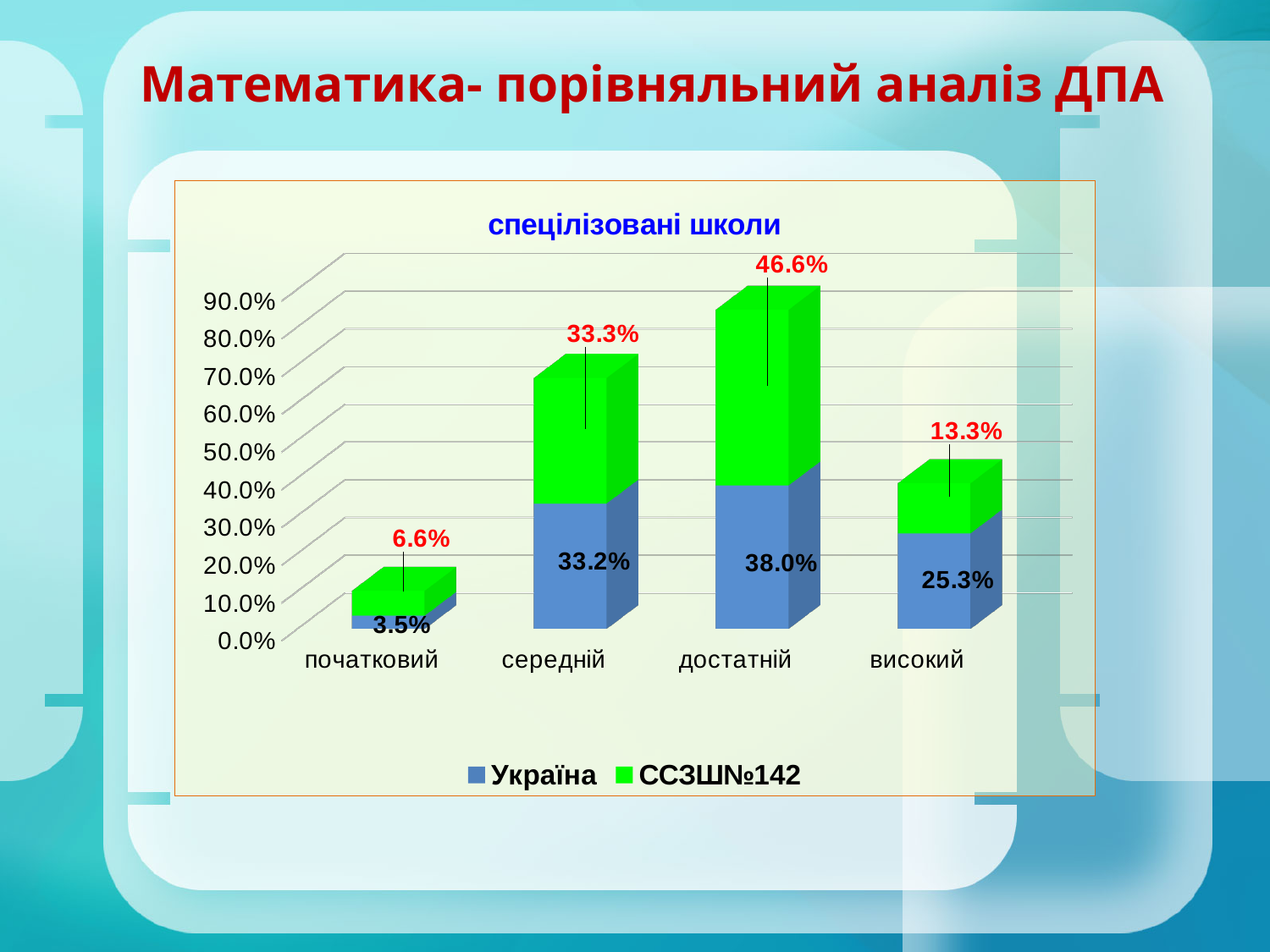
Is the total of the stacked bar for достатній greater or less than 80.0%? greater What is the difference between the ССЗШ№142 and Україна values in the достатній category? 8.6% What is the value for ССЗШ№142 in the високий category? 13.3% How many categories are shown on the x axis? 4 What is the value for Україна in the початковий category? 3.5% How many series does the legend list? 2 Which category has the highest value for ССЗШ№142? достатній What is the value for Україна in the достатній category? 38.0% What kind of chart is shown on the slide? stacked bar chart In the високий category, which series has the larger value, Україна or ССЗШ№142? Україна What is the total of the stacked bar for the середній category? 66.5% Which category has the lowest value for Україна? початковий